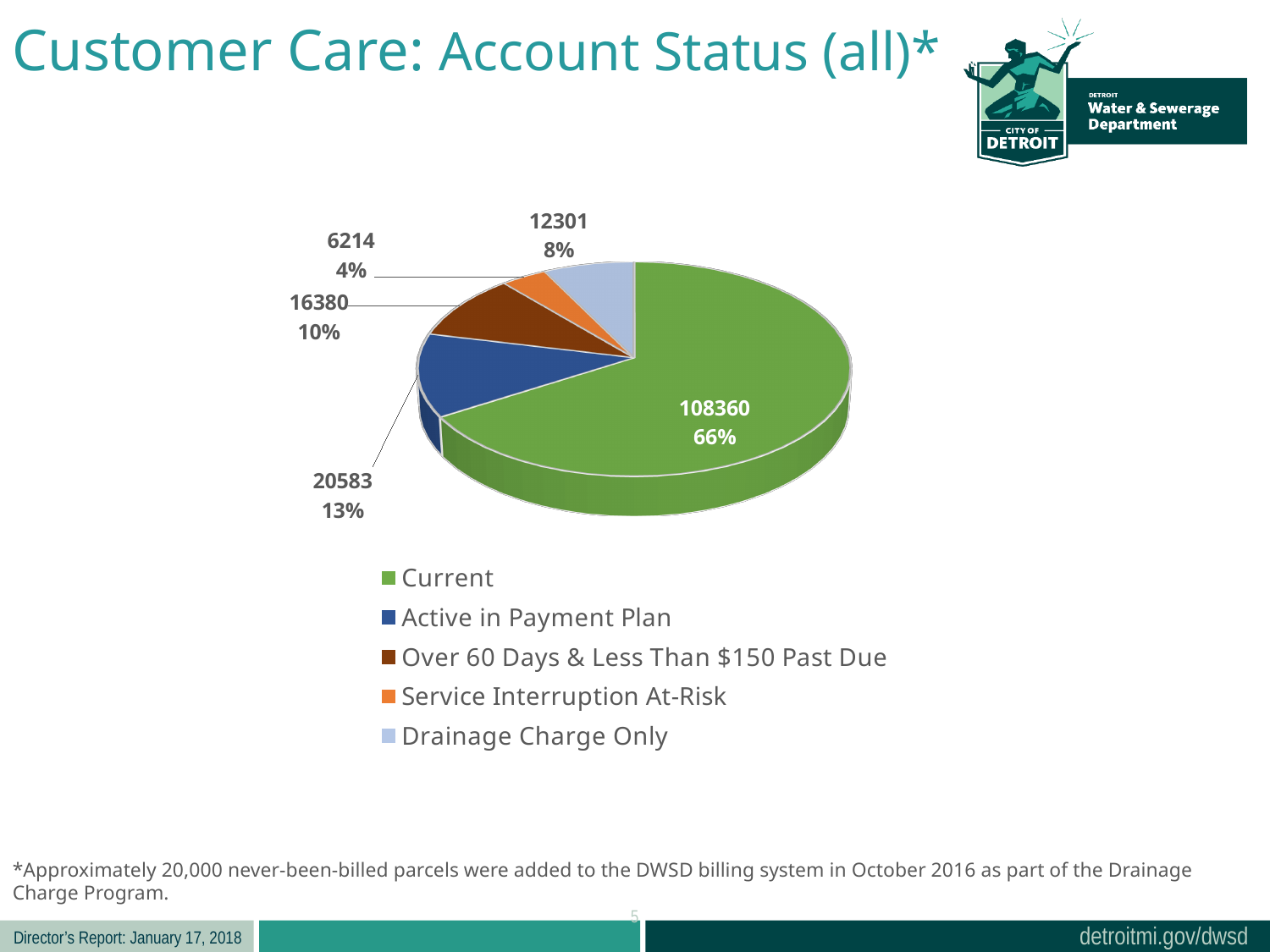
What share of the pie does Over 60 Days & Less Than $150 Past Due represent? 10% What is the value for Active in Payment Plan? 20583 What is the difference between the values for Active in Payment Plan and Over 60 Days & Less Than $150 Past Due? 4203 What is the value for Service Interruption At-Risk? 6214 What share of the pie does Current represent? 66% Which category has the smallest slice? Service Interruption At-Risk Which category has the largest slice? Current What is the value for Current? 108360 What kind of chart is shown on the slide? Pie chart How many entries does the legend list? 5 What is the value for Drainage Charge Only? 12301 How many slices does the pie chart have? 5